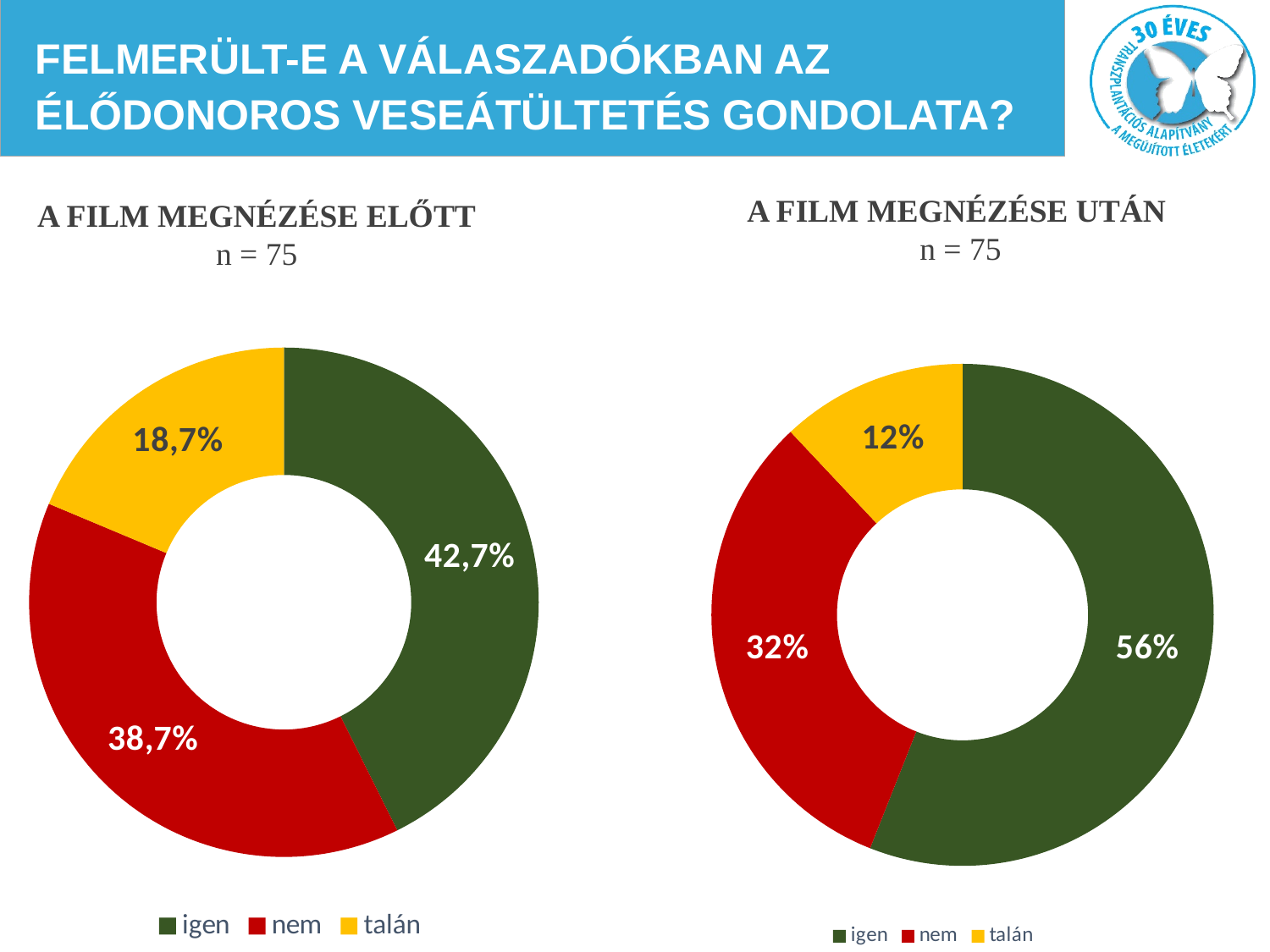
In the chart titled "A FILM MEGNÉZÉSE ELŐTT", what is the share for "igen"? 42,7% In the chart titled "A FILM MEGNÉZÉSE UTÁN", which category has the largest share? igen In the chart titled "A FILM MEGNÉZÉSE ELŐTT", which category has the smallest share? talán In the chart titled "A FILM MEGNÉZÉSE UTÁN", what is the difference between the shares for "igen" and "nem"? 24% In the chart titled "A FILM MEGNÉZÉSE UTÁN", what is the share for "talán"? 12% In the chart titled "A FILM MEGNÉZÉSE UTÁN", what is the share for "igen"? 56% What kind of chart is the chart titled "A FILM MEGNÉZÉSE ELŐTT"? Doughnut (pie) chart In the chart titled "A FILM MEGNÉZÉSE UTÁN", what is the share for "nem"? 32% In the chart titled "A FILM MEGNÉZÉSE ELŐTT", what is the share for "talán"? 18,7% In the chart titled "A FILM MEGNÉZÉSE ELŐTT", what is the share for "nem"? 38,7% In the chart titled "A FILM MEGNÉZÉSE ELŐTT", which is larger, the share for "igen" or the share for "nem"? igen How many categories does the chart titled "A FILM MEGNÉZÉSE UTÁN" show? 3